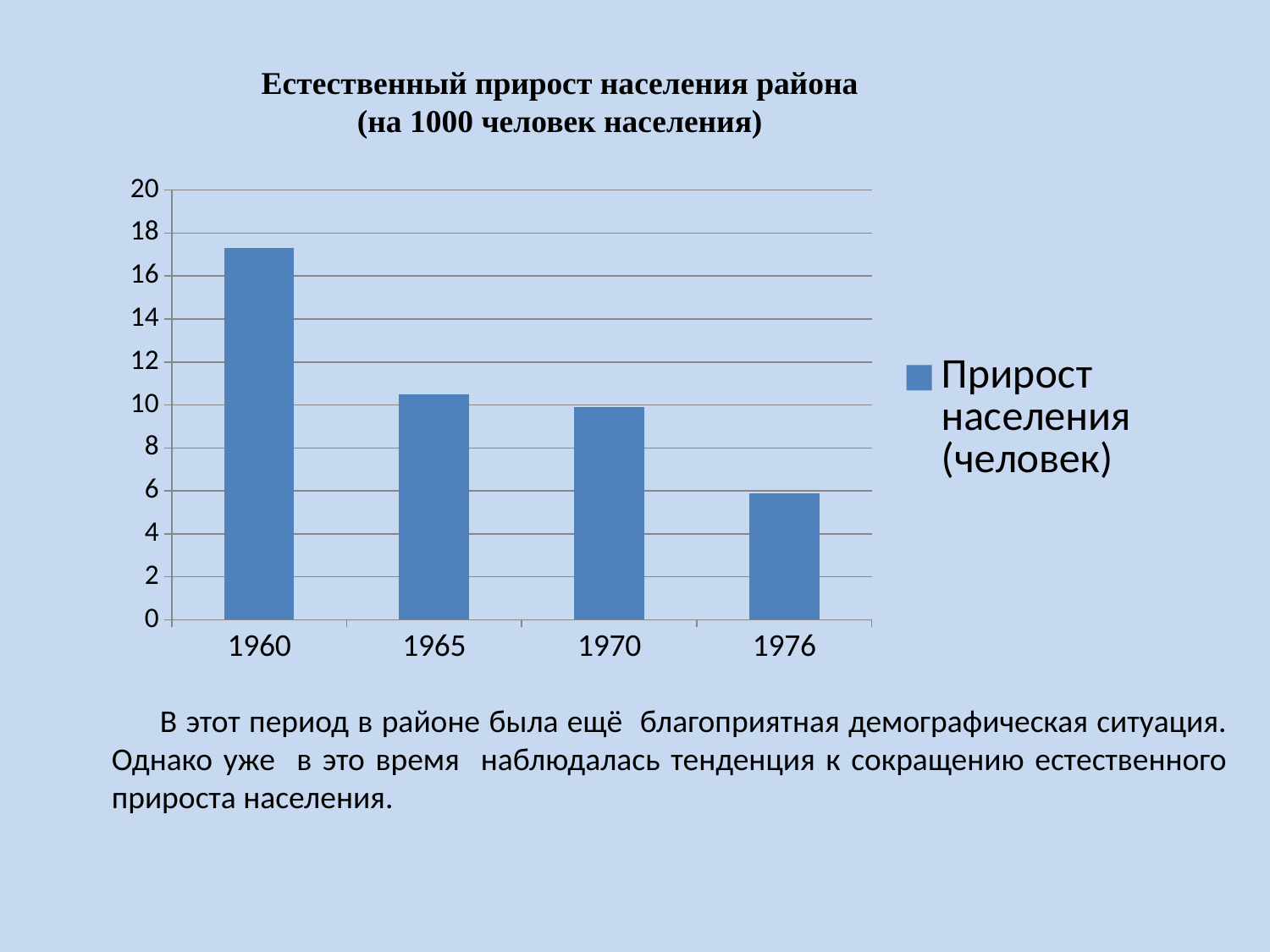
Which year has the highest natural population growth in the chart? 1960 What is the legend entry of the series shown in the chart? Прирост населения (человек) Which year has the lowest natural population growth in the chart? 1976 How many years (categories) are shown on the x axis of the chart? 4 Is the value for 1965 greater or less than 12? less Is the value for 1960 greater or less than 16? greater Is the value for 1970 greater or less than 8? greater How many series does the chart's legend list? 1 Which is larger, the value for 1960 or the value for 1976? 1960 Do the values in the chart rise or fall from 1960 to 1976? Fall What kind of chart is shown on the slide? Bar chart